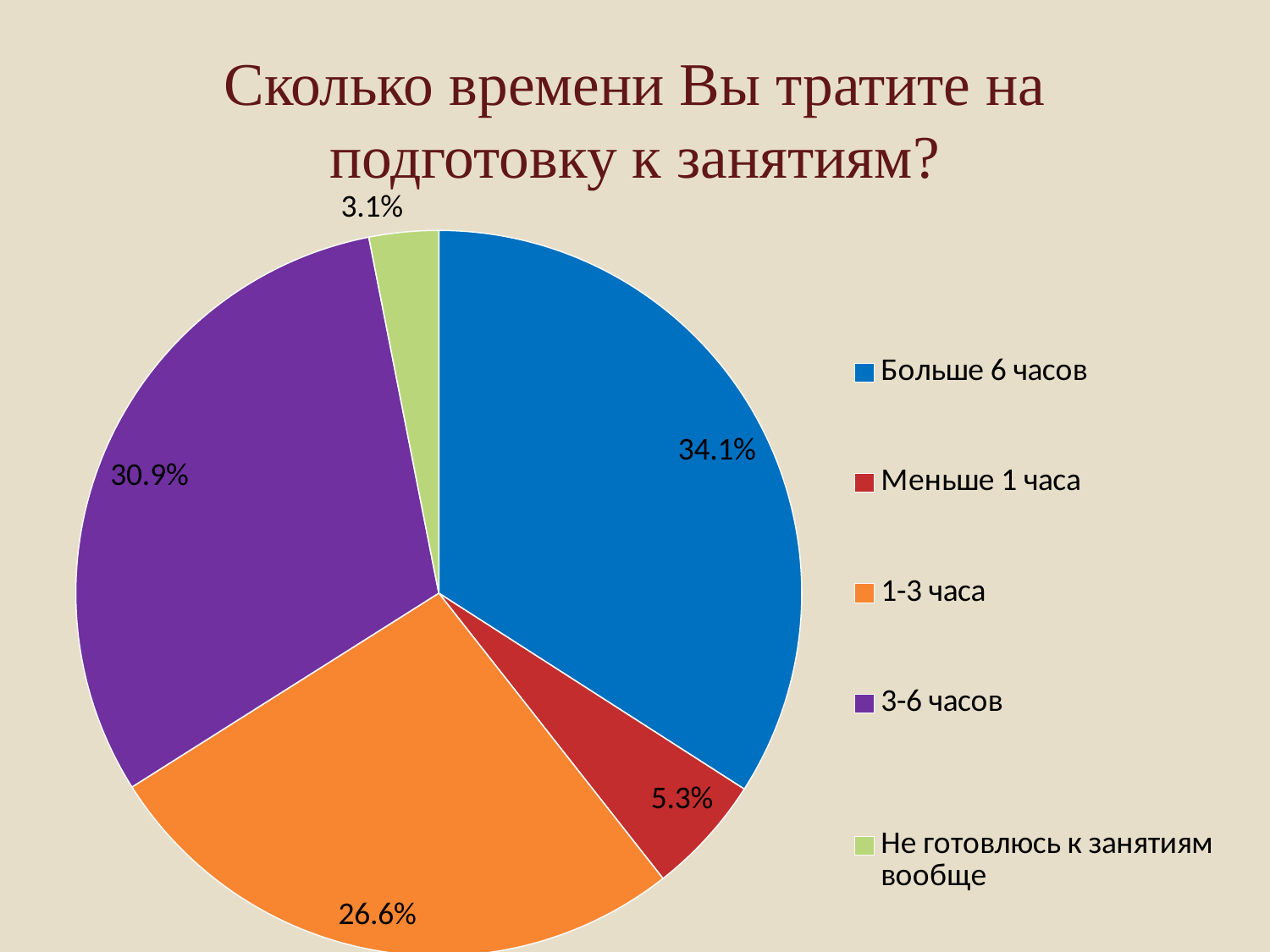
What type of chart is shown on the slide? pie chart What share of the pie is labelled for "Не готовлюсь к занятиям вообще"? 3.1% What is the difference in percentage points between "Больше 6 часов" and "3-6 часов"? 3.2 Which category has the largest slice of the pie? Больше 6 часов Which category has the smallest slice of the pie? Не готовлюсь к занятиям вообще How many categories does the legend list? 5 Which is larger: the slice for "1-3 часа" or the slice for "Меньше 1 часа"? 1-3 часа What share of the pie is labelled for "3-6 часов"? 30.9% What share of the pie is labelled for "1-3 часа"? 26.6% What is the title of the chart? Сколько времени Вы тратите на подготовку к занятиям? What share of the pie is labelled for "Меньше 1 часа"? 5.3% What share of the pie is labelled for "Больше 6 часов"? 34.1%